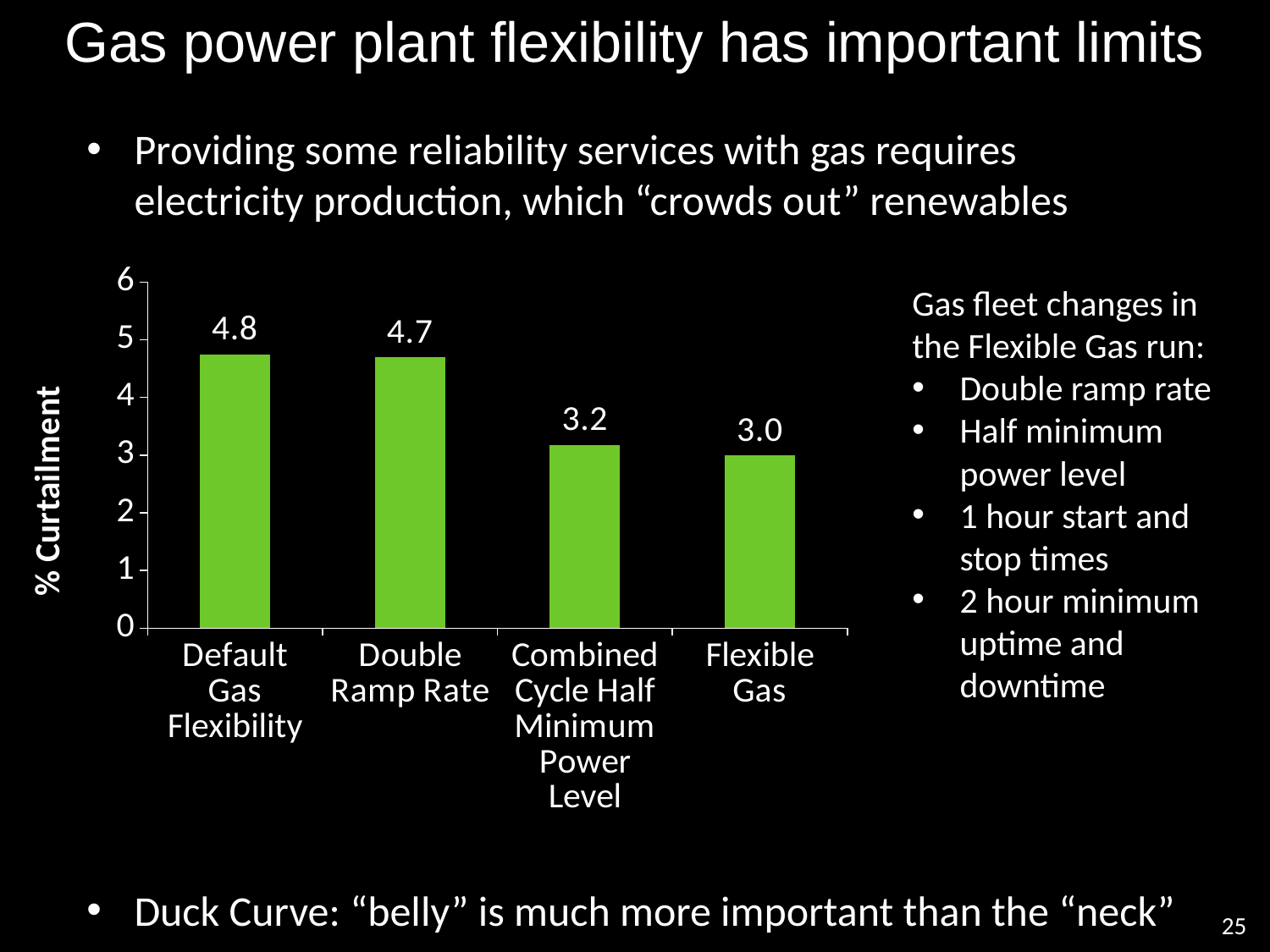
What is the label of the vertical axis of the chart? % Curtailment Which has a higher % Curtailment, Double Ramp Rate or Flexible Gas? Double Ramp Rate What is the difference in % Curtailment between Default Gas Flexibility and Flexible Gas? 1.8 What is the % Curtailment value for Combined Cycle Half Minimum Power Level? 3.2 How many categories are shown in the chart? 4 What is the % Curtailment value for Default Gas Flexibility? 4.8 What kind of chart is shown on the slide? bar chart Which category has the lowest % Curtailment? Flexible Gas Is the value for Combined Cycle Half Minimum Power Level greater or less than 4? less What is the % Curtailment value for Flexible Gas? 3.0 What is the difference in % Curtailment between Double Ramp Rate and Combined Cycle Half Minimum Power Level? 1.5 Which category has the highest % Curtailment? Default Gas Flexibility